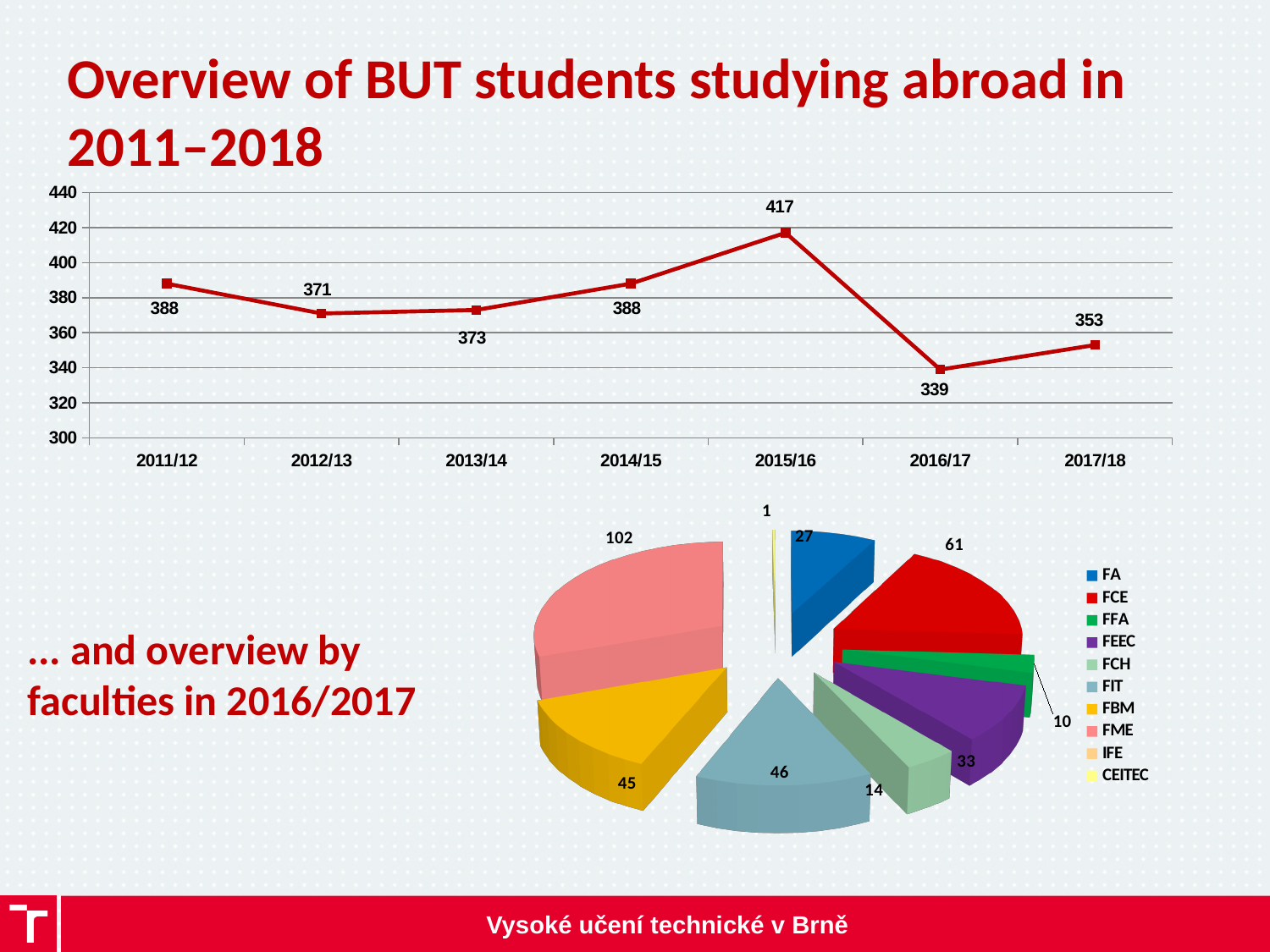
In the pie chart showing faculties in 2016/2017, which faculty has the largest slice? FME In the line chart at the top, is the value for 2012/13 or 2017/18 larger? 2012/13 In the line chart at the top, what is the difference between the values for 2015/16 and 2016/17? 78 How many entries does the legend of the pie chart list? 10 What kind of chart is the top chart on the slide? Line chart In the line chart at the top, how many academic years are plotted? 7 In the pie chart showing faculties in 2016/2017, what is the value for FME? 102 In the line chart at the top, how many students studied abroad in 2015/16? 417 In the line chart at the top, what is the value for 2016/17? 339 In the line chart at the top, do the values rise or fall from 2013/14 to 2015/16? Rise In the line chart at the top, which academic year has the highest value? 2015/16 In the line chart at the top, which academic year has the lowest value? 2016/17